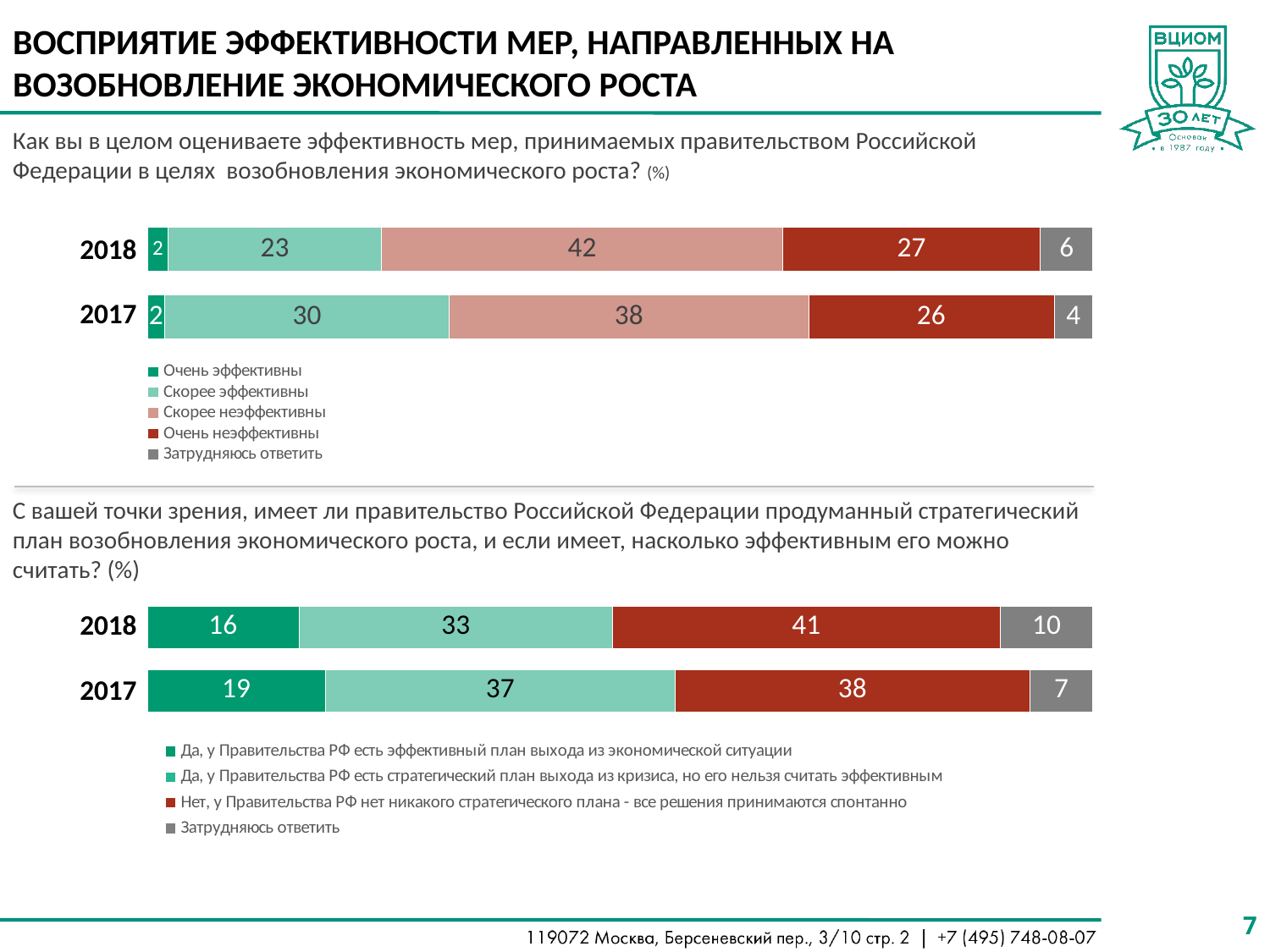
What type of chart is the bottom chart? Stacked bar chart In the top chart, what is the value for "Затрудняюсь ответить" in 2018? 6 In the bottom chart, what is the value for "Нет, у Правительства РФ нет никакого стратегического плана - все решения принимаются спонтанно" in 2018? 41 In the top chart, what is the value for "Скорее неэффективны" in 2018? 42 In the top chart, what is the value for "Скорее эффективны" in 2017? 30 In the bottom chart, how many series does the legend list? 4 In the top chart, how many series does the legend list? 5 In the top chart, what is the difference between the "Скорее эффективны" values for 2017 and 2018? 7 In the bottom chart, what is the difference between the "Затрудняюсь ответить" values for 2018 and 2017? 3 In the bottom chart, which is larger: the "Затрудняюсь ответить" value for 2018 or for 2017? 2018 In the top chart, which segment is the largest in the 2018 bar? Скорее неэффективны In the bottom chart, what is the value for "Да, у Правительства РФ есть эффективный план выхода из экономической ситуации" in 2017? 19